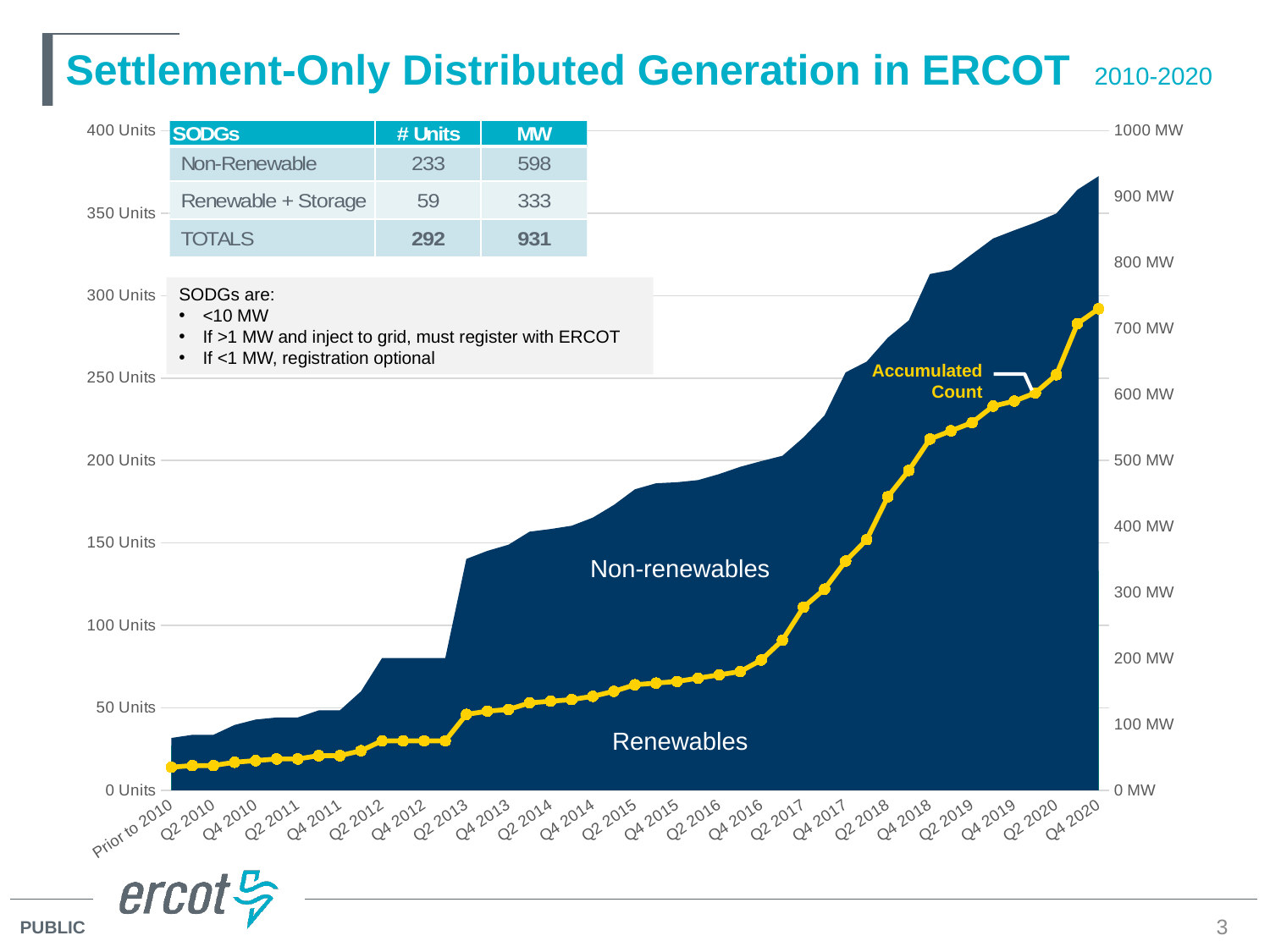
How many data series are labelled on the chart? 3 What unit is shown on the right-hand vertical axis of the chart? MW What kind of chart is shown on the slide? Stacked area chart with a line Is the total stacked MW at Q4 2020 greater or less than 900 MW? greater Which series is plotted as the yellow line with markers? Accumulated Count Is the Accumulated Count at Q4 2020 greater or less than 250 Units? greater Which of the two stacked areas is larger at Q4 2020, Non-renewables or Renewables? Non-renewables Is the Accumulated Count at Q4 2017 greater or less than 150 Units? less Does the Accumulated Count line rise or fall from Prior to 2010 to Q4 2020? Rise